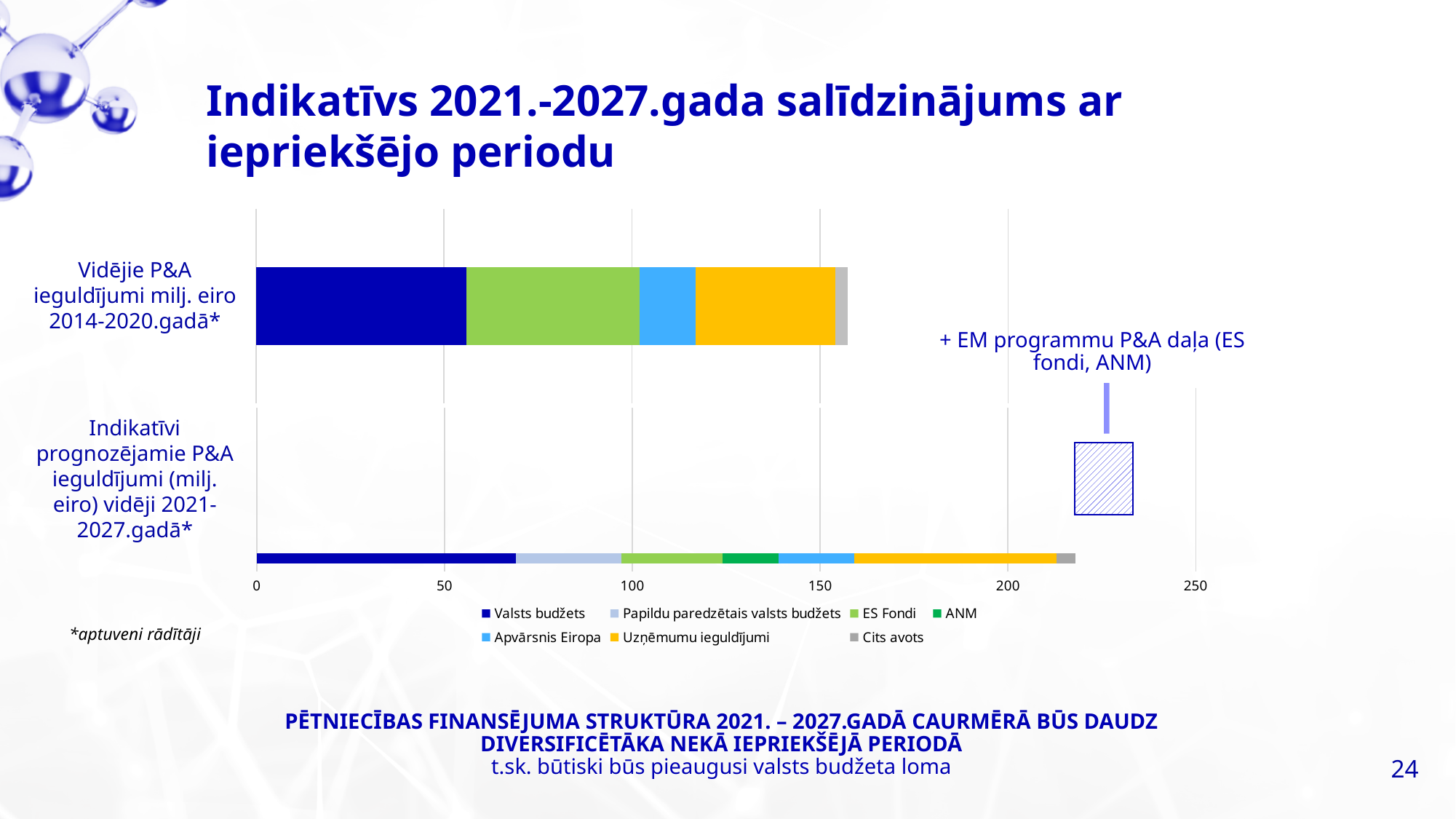
Which period has the larger 'Valsts budžets' segment: 2014-2020 or 2021-2027? 2021-2027 Which period has the longer total bar: 2014-2020 or 2021-2027? 2021-2027 Is the total length of the bar for 'Indikatīvi prognozējamie P&A ieguldījumi (milj. eiro) vidēji 2021-2027.gadā*' greater or less than 200? greater How many categories (bars) does the chart show? 2 How many series does the legend list? 7 What is the highest value shown on the x axis? 250 Is the 'Valsts budžets' segment for 2014-2020 greater or less than 50? greater Is the 'Valsts budžets' segment for 2021-2027 greater or less than 100? less What kind of chart is shown on the slide? Stacked bar chart Which series is shown in yellow in the legend? Uzņēmumu ieguldījumi